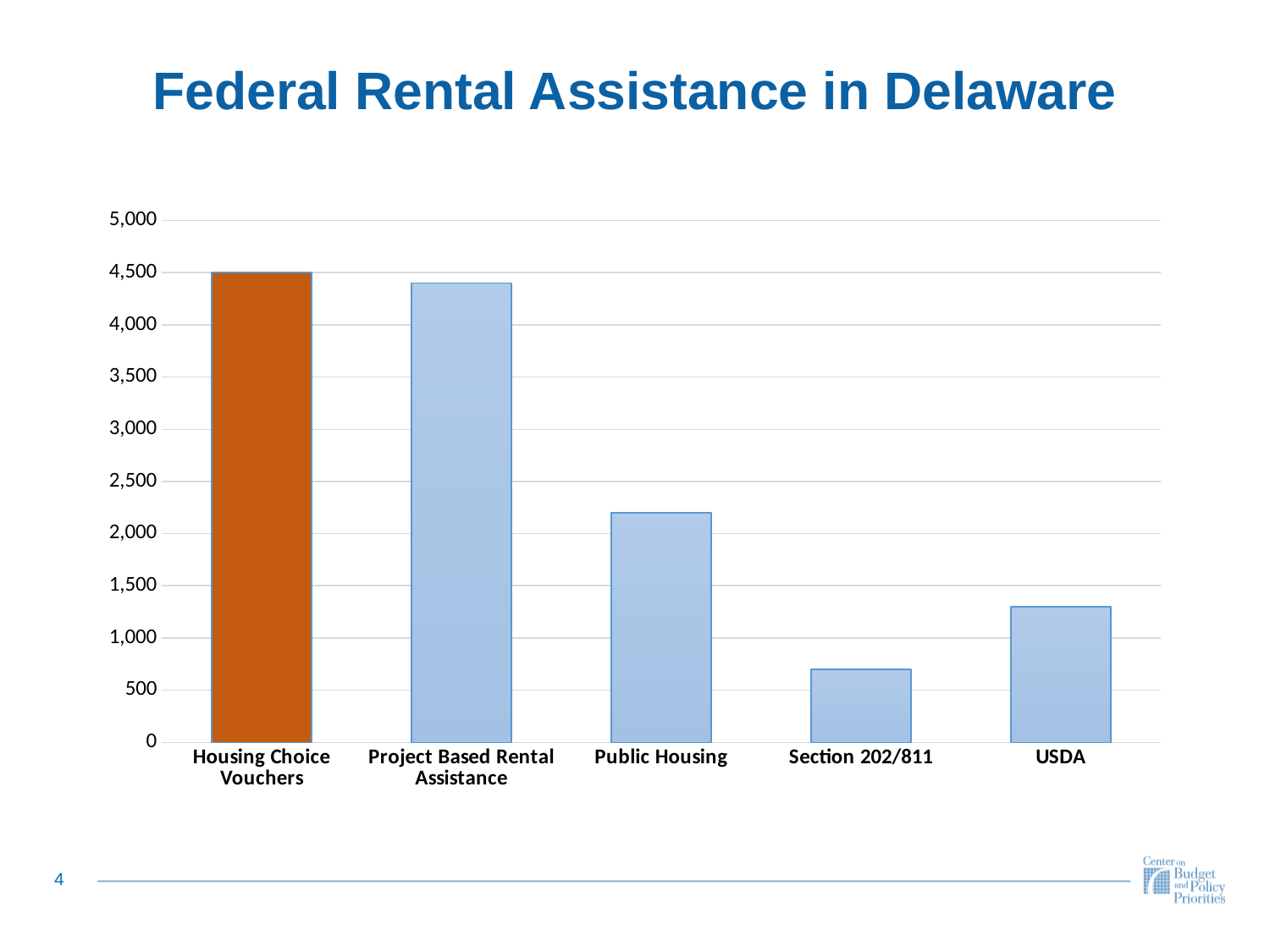
Which category's bar is coloured orange rather than blue? Housing Choice Vouchers What kind of chart is shown on the slide? Bar chart Is the value for Section 202/811 greater or less than 1,000? less Is the value for Housing Choice Vouchers greater or less than 4,000? greater Which category has the lowest value? Section 202/811 Is the value for Project Based Rental Assistance greater or less than 4,000? greater What is the title of the chart? Federal Rental Assistance in Delaware Which is larger, the value for Public Housing or the value for USDA? Public Housing Which is larger, the value for Section 202/811 or the value for USDA? USDA How many categories are shown on the x axis? 5